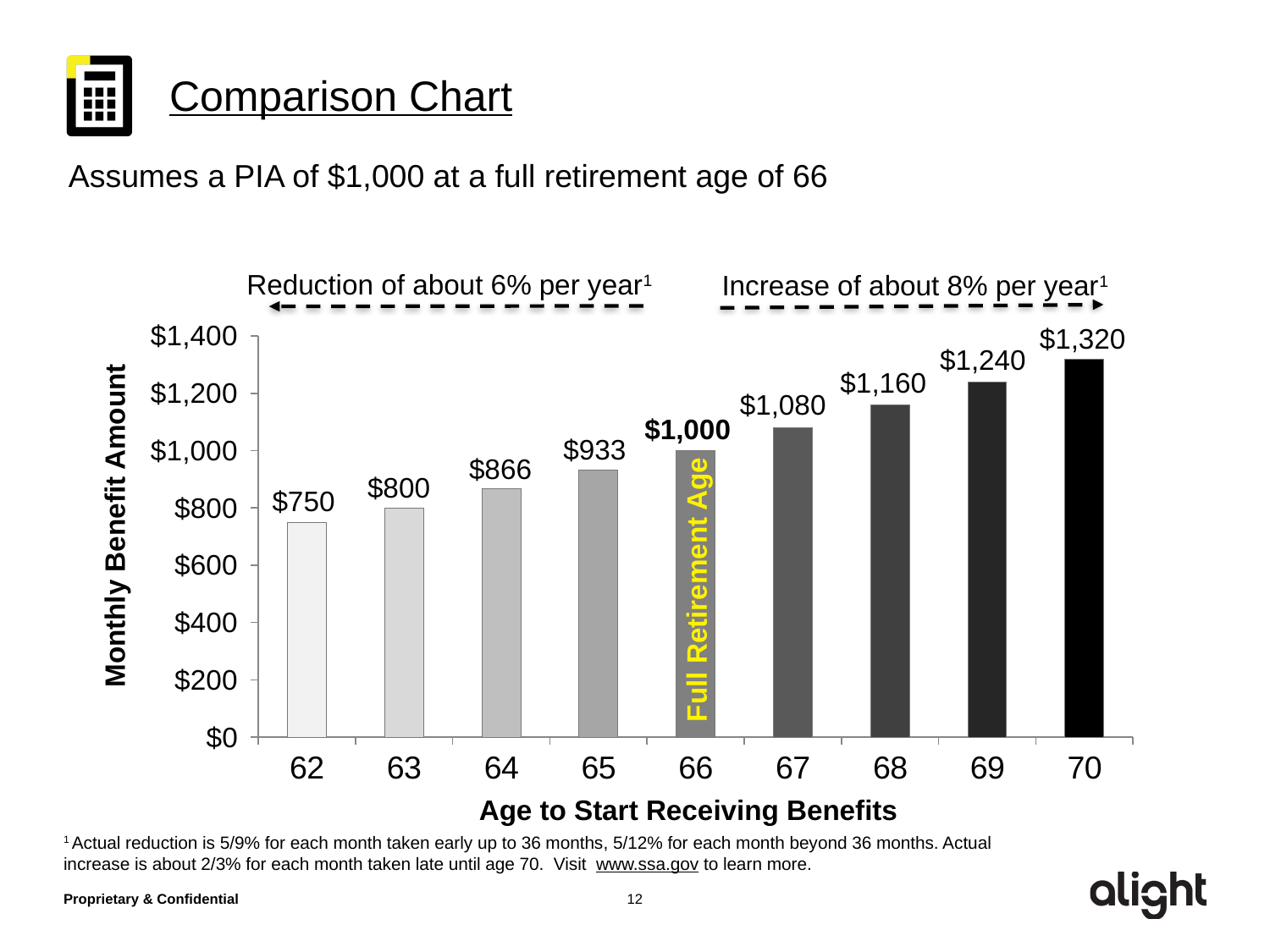
What is the monthly benefit amount for starting benefits at age 64? $866 What is the difference in monthly benefit amount between starting at age 70 and starting at age 66? $320 Is the monthly benefit amount for starting at age 69 greater or less than $1,200? greater How many ages to start receiving benefits are shown on the x axis? 9 Which age to start receiving benefits has the highest monthly benefit amount? 70 Do the monthly benefit amounts rise or fall as the age to start receiving benefits increases from 62 to 70? Rise What is the difference in monthly benefit amount between starting at age 65 and starting at age 63? $133 What is the monthly benefit amount for starting benefits at age 68? $1,160 What kind of chart is shown on the slide? Bar chart What is the monthly benefit amount for starting benefits at age 62? $750 Which has a larger monthly benefit amount: starting at age 67 or starting at age 65? 67 Which age to start receiving benefits has the lowest monthly benefit amount? 62